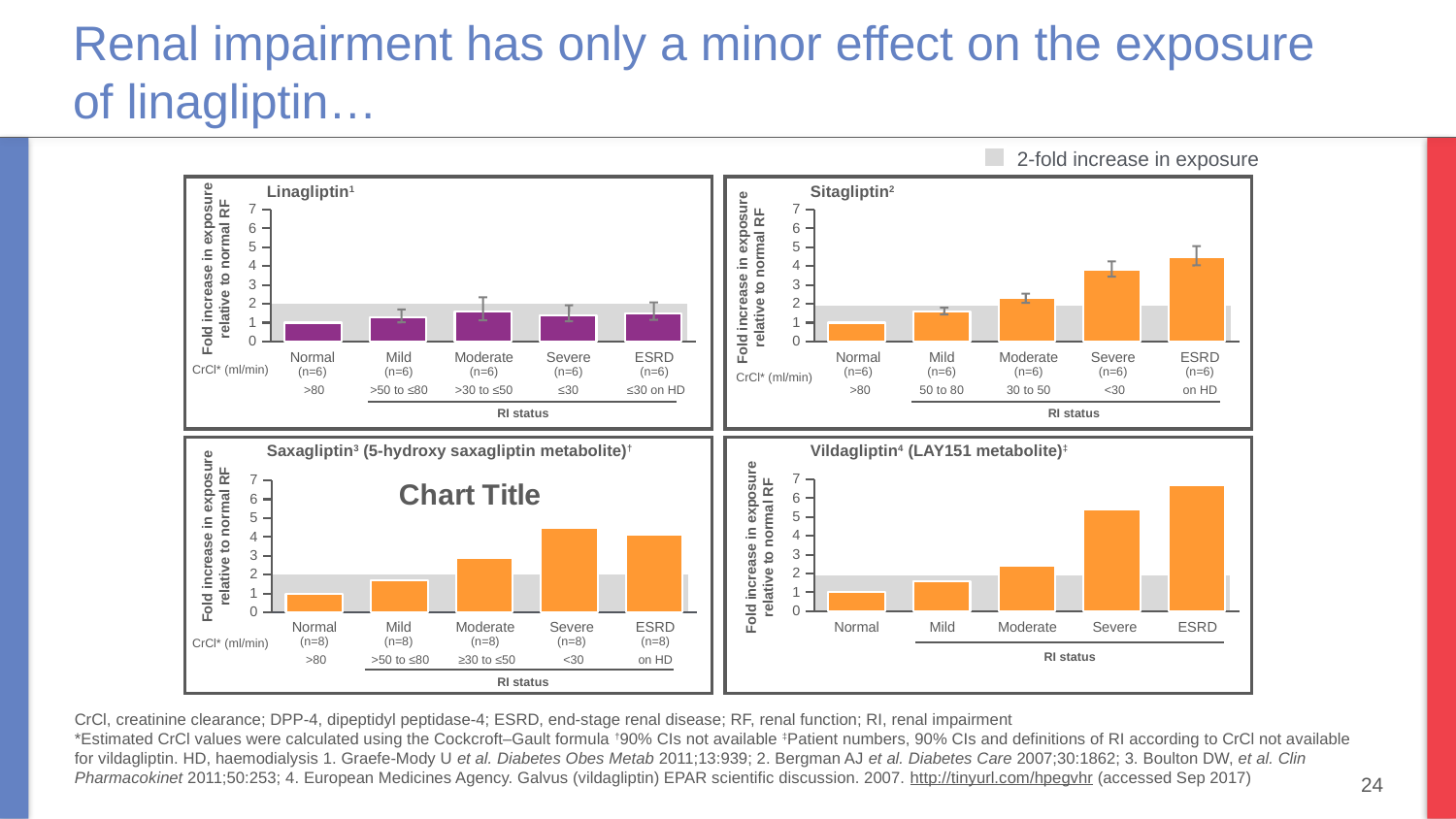
In the Linagliptin chart, is the value for Severe greater or less than 2? less In the Linagliptin chart, how many RI status categories are shown? 5 In the Saxagliptin chart, is the value for Moderate greater or less than 2? greater What kind of chart is the Linagliptin chart? bar chart In the Sitagliptin chart, which RI status category has the lowest fold increase in exposure? Normal In the Vildagliptin chart, which RI status category has the highest fold increase in exposure? ESRD What does the grey band shown across all four charts represent, according to the legend? 2-fold increase in exposure In the Vildagliptin chart, is the value for ESRD greater or less than 6? greater In the Sitagliptin chart, which is larger, the value for Severe or the value for Moderate? Severe In the Sitagliptin chart, which RI status category has the highest fold increase in exposure? ESRD In the Vildagliptin chart, do the values rise or fall from Normal to ESRD along the x axis? rise